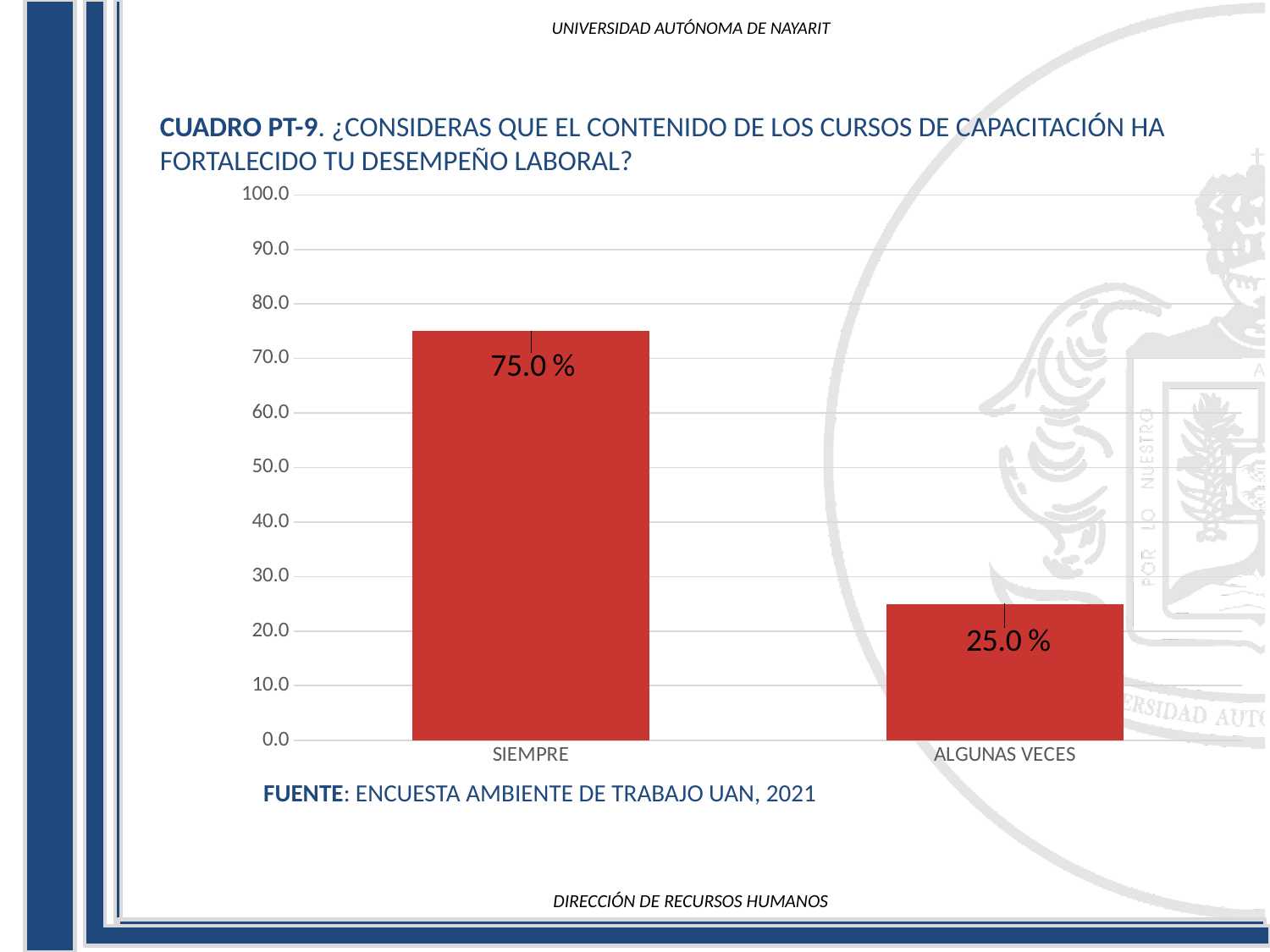
How many categories are shown on the x axis? 2 Do the values rise or fall from SIEMPRE to ALGUNAS VECES? Fall Is the value for ALGUNAS VECES greater or less than 30.0? less What is the value for ALGUNAS VECES? 25.0 % Is the value for SIEMPRE greater or less than 70.0? greater What is the value for SIEMPRE? 75.0 % What is the difference between the values for SIEMPRE and ALGUNAS VECES? 50.0 % Which category has the lowest value? ALGUNAS VECES Which category has the highest value? SIEMPRE What source is cited below the chart? ENCUESTA AMBIENTE DE TRABAJO UAN, 2021 What kind of chart is shown on the slide? Bar chart Which is larger, the value for SIEMPRE or the value for ALGUNAS VECES? SIEMPRE